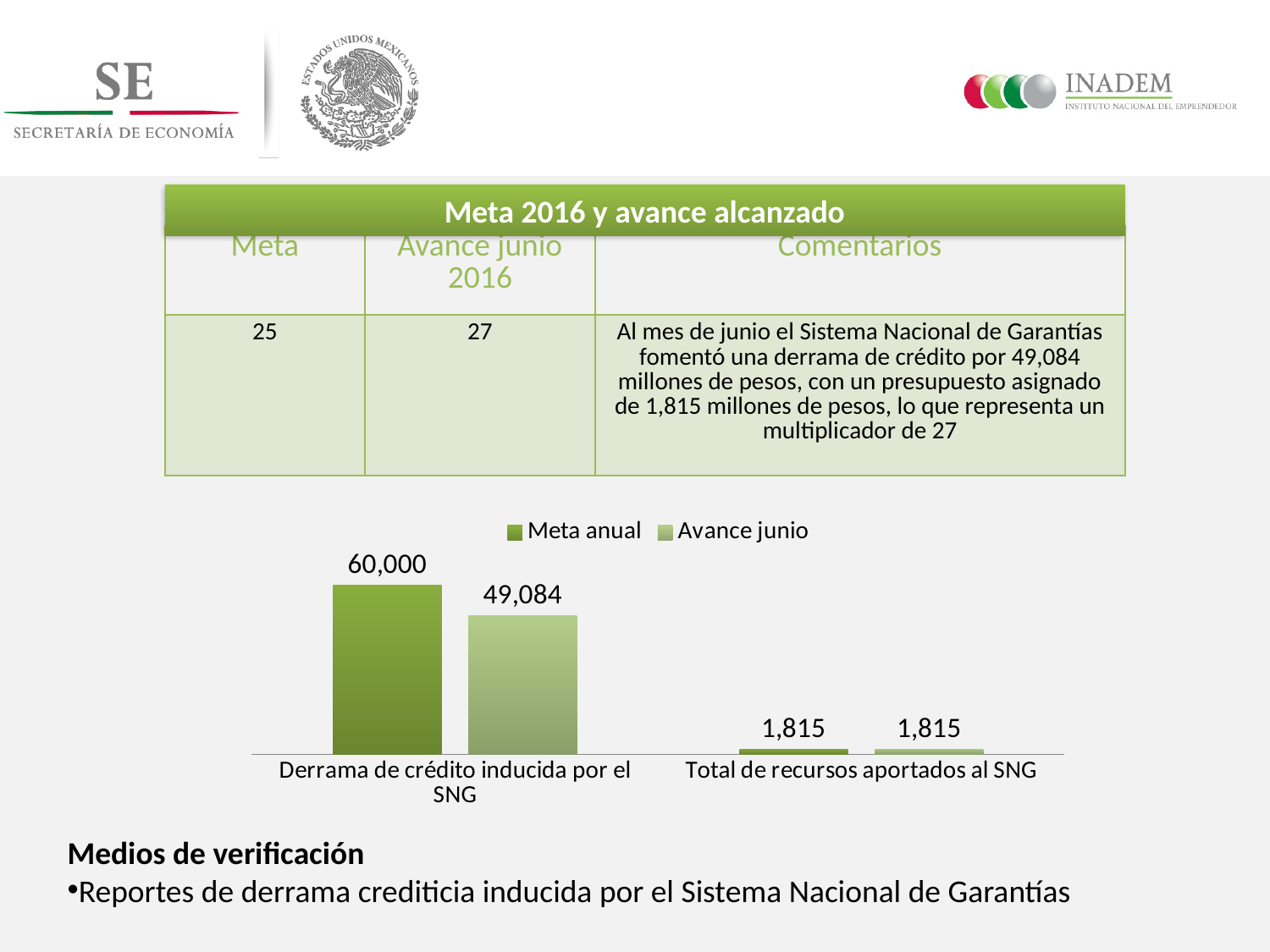
What is the Avance junio value for Total de recursos aportados al SNG? 1,815 For Derrama de crédito inducida por el SNG, which is larger: Meta anual or Avance junio? Meta anual What is the Meta anual value for Derrama de crédito inducida por el SNG? 60,000 Which category has the highest Meta anual value? Derrama de crédito inducida por el SNG How many series does the chart legend list? 2 What kind of chart is shown on the slide? Bar chart What are the two series names listed in the chart legend? Meta anual and Avance junio What is the Avance junio value for Derrama de crédito inducida por el SNG? 49,084 What is the Meta anual value for Total de recursos aportados al SNG? 1,815 What is the difference between the Meta anual and Avance junio values for Derrama de crédito inducida por el SNG? 10,916 Which category has the lowest Avance junio value? Total de recursos aportados al SNG How many categories are shown on the x axis of the chart? 2